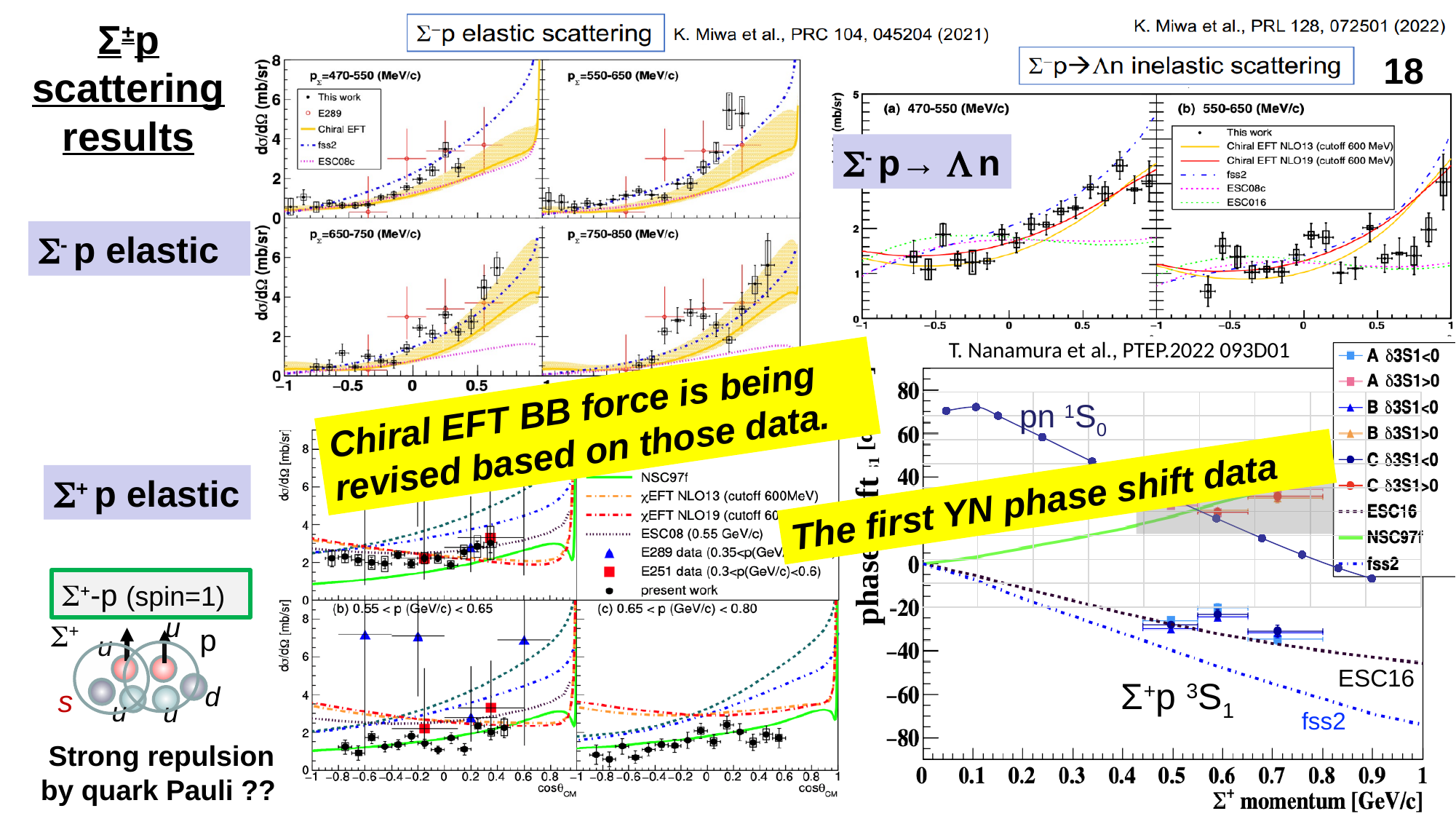
In the bottom-right phase shift chart, is the pn ¹S₀ phase shift at 0.1 GeV/c greater or less than 60? greater In the Σ⁻p→Λn inelastic scattering chart, panel (a) 470-550 MeV/c, do the data points rise or fall as cosθ increases? rise In the bottom-right phase shift chart, does the pn ¹S₀ phase shift rise or fall as momentum increases beyond 0.1 GeV/c? fall How many entries does the legend of the Σ⁻p→Λn inelastic scattering chart (top-right) list? 6 In the bottom-right phase shift chart, is the ESC16 curve at 1 GeV/c greater or less than -60? greater In the bottom-right phase shift chart, is the fss2 curve for Σ⁺p ³S₁ at 1 GeV/c greater or less than -60? less How many panels does the Σ⁻p→Λn inelastic scattering chart (top-right) contain? 2 What kind of chart is the bottom-right plot of phase shift versus Σ⁺ momentum? line chart What is the x-axis label of the bottom-right phase shift chart? Σ⁺ momentum [GeV/c] How many entries does the legend of the bottom-right phase shift chart list? 9 How many momentum-range panels does the Σ⁻p elastic scattering chart (top-left) contain? 4 How many entries does the legend of the Σ⁻p elastic scattering chart (top-left) list? 5